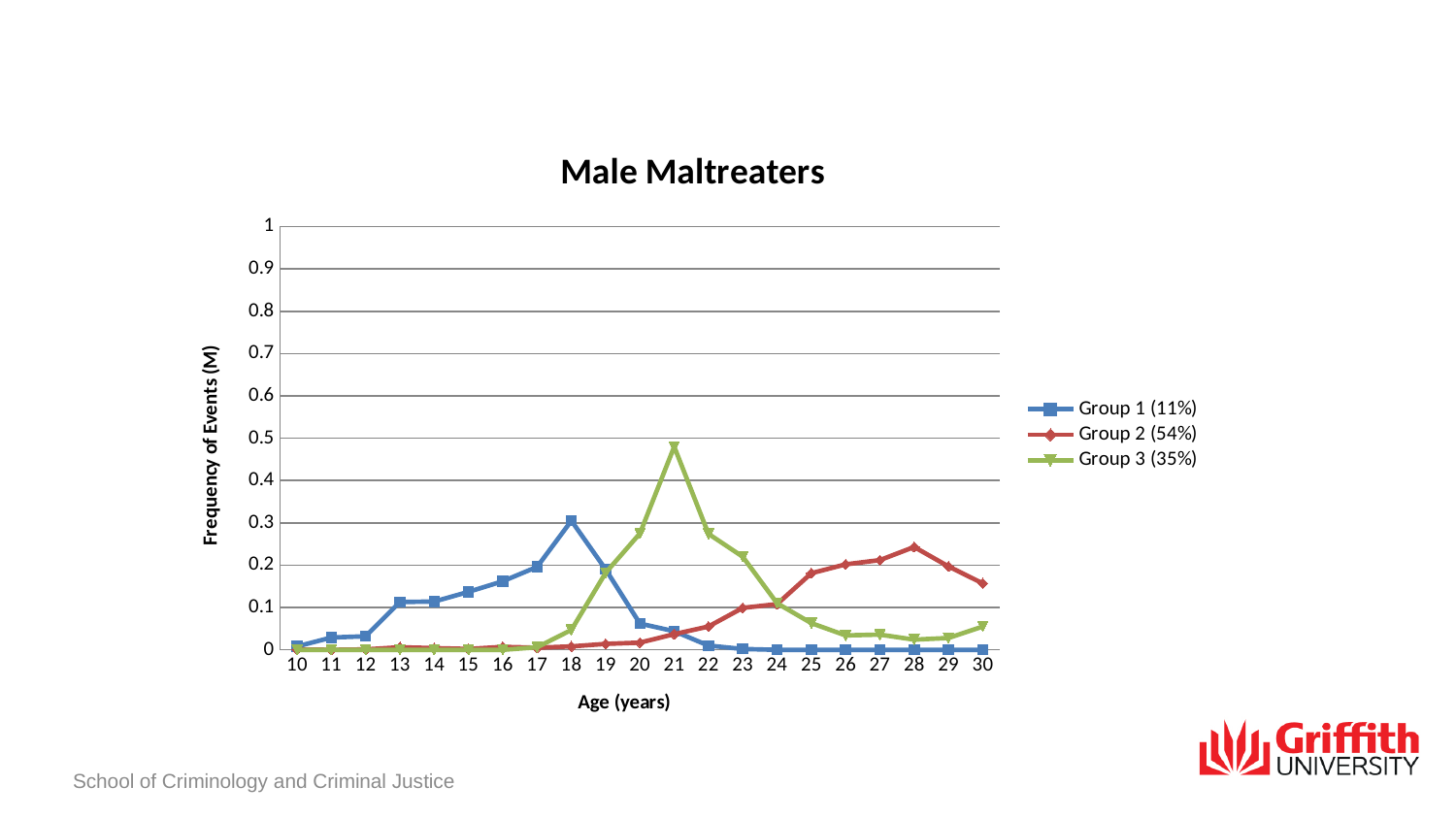
At what age does Group 3 (35%) reach its peak? 21 What is the title of the y axis? Frequency of Events (M) At age 21, which is larger: the value for Group 3 (35%) or Group 1 (11%)? Group 3 (35%) How many series does the legend list? 3 Is the value for Group 2 (54%) at age 28 greater or less than 0.3? less Is the value for Group 1 (11%) at age 18 greater or less than 0.2? greater Is the value for Group 3 (35%) at age 21 greater or less than 0.4? greater How many age values are plotted along the x axis? 21 What kind of chart is shown on the slide? line chart At what age does Group 1 (11%) reach its peak? 18 Which group reaches the highest peak frequency of events? Group 3 (35%) At what age does Group 2 (54%) reach its peak? 28